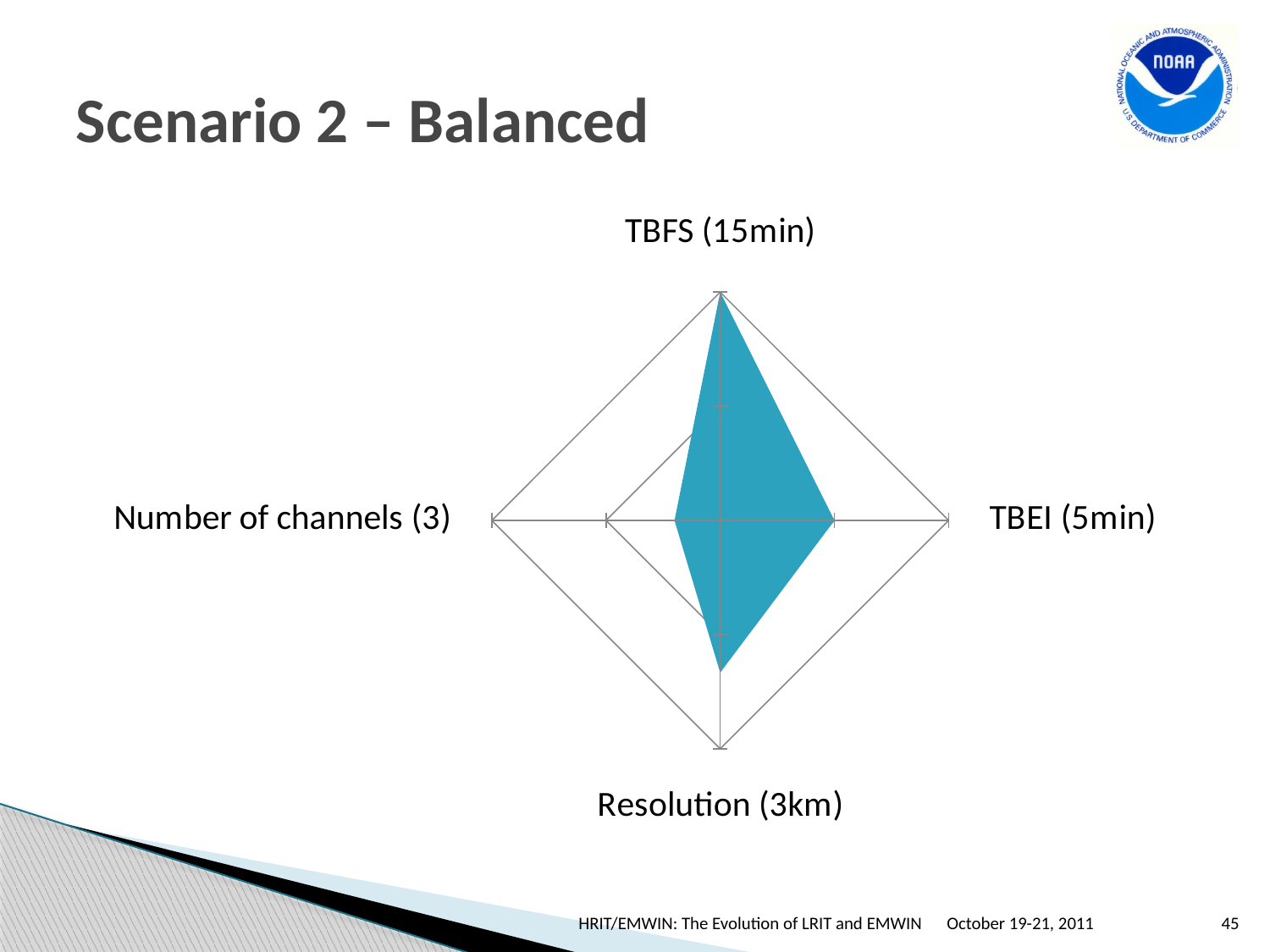
Which category has the lowest value on the radar chart? Number of channels (3) Which category has the highest value on the radar chart? TBFS (15min) Which is larger on the radar chart, the value for TBFS (15min) or the value for Resolution (3km)? TBFS (15min) How many axes (categories) does the radar chart have? 4 Which is larger on the radar chart, the value for Resolution (3km) or the value for TBEI (5min)? Resolution (3km) What kind of chart is shown on the slide? Radar chart Which category label appears at the bottom of the radar chart? Resolution (3km) What is the title of the slide containing the radar chart? Scenario 2 – Balanced Which is larger on the radar chart, the value for TBEI (5min) or the value for Number of channels (3)? TBEI (5min)